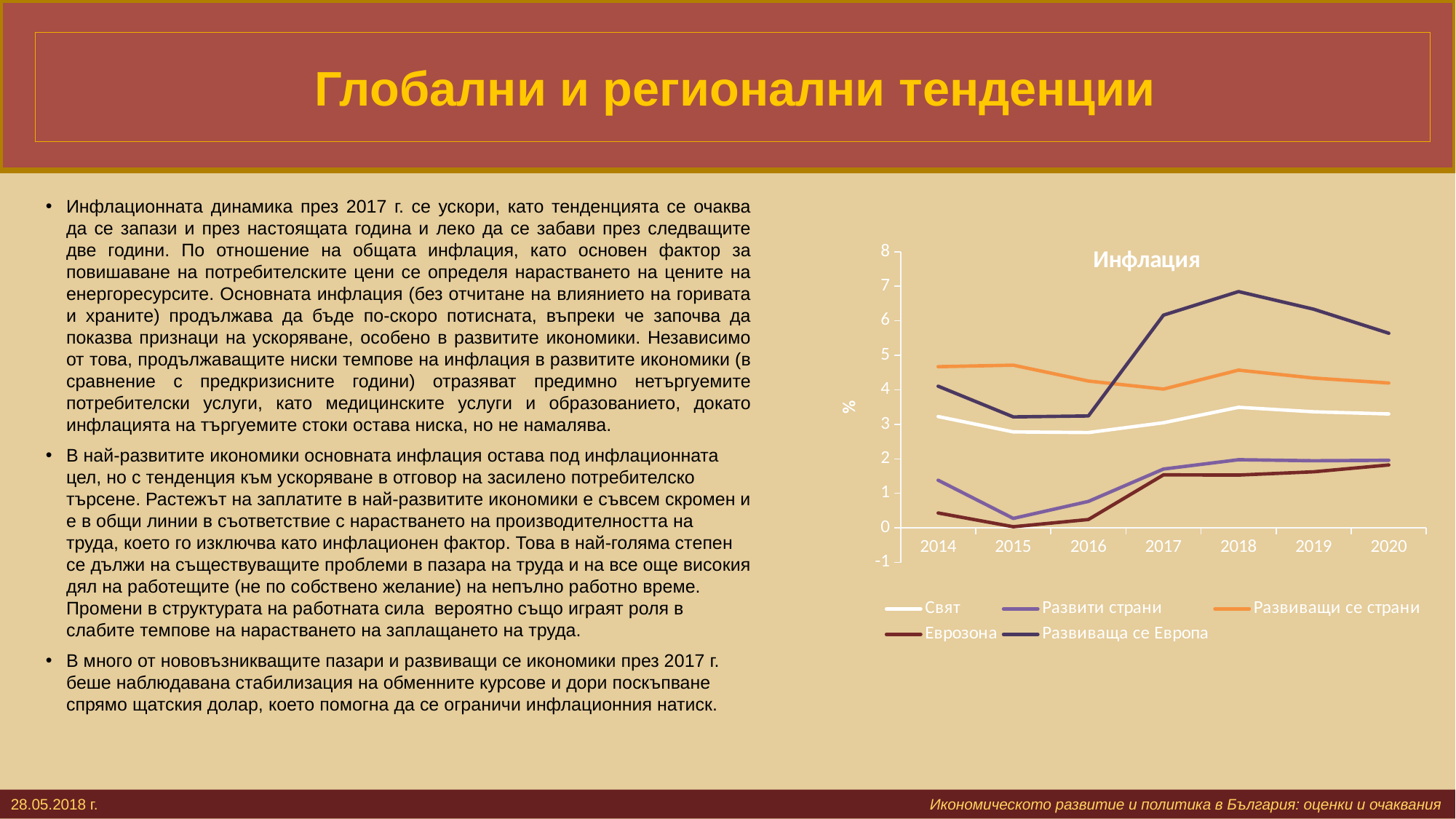
Is the value for Еврозона in 2014 greater or less than 1? less Which series has the highest value in 2018? Развиваща се Европа Is the value for Свят in 2018 greater or less than 3? greater In 2014, which is larger: the value for Развиващи се страни or the value for Развиваща се Европа? Развиващи се страни What is the title of the chart? Инфлация What kind of chart is shown on the slide? line chart How many years are shown on the x axis of the chart? 7 How many series does the legend of the chart list? 5 Which series has the lowest value in 2015? Еврозона Is the value for Развиваща се Европа in 2018 greater or less than 6? greater Does the value for Развиваща се Европа rise or fall from 2018 to 2020? fall Does the value for Еврозона rise or fall from 2016 to 2017? rise